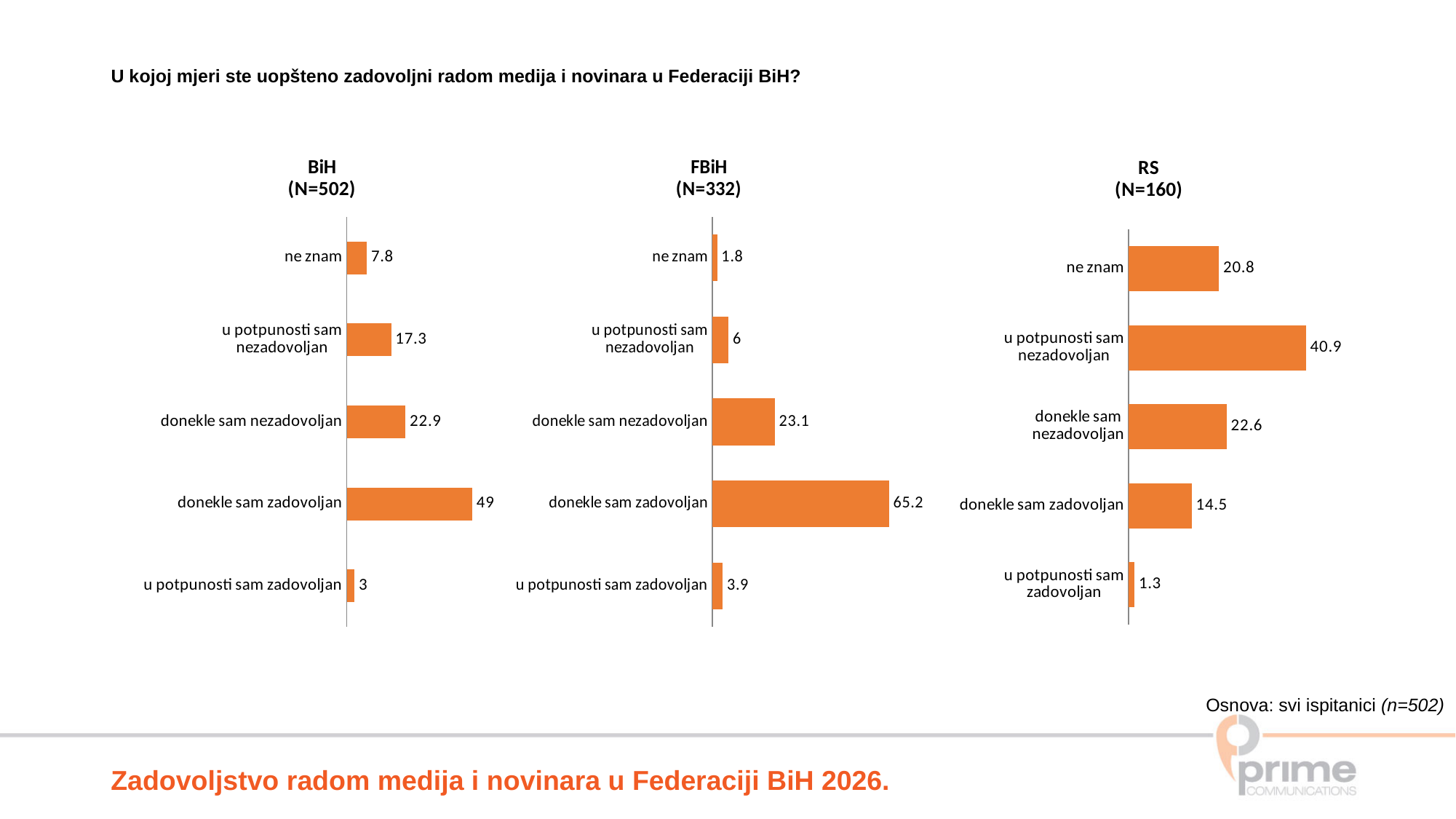
In the FBiH (N=332) chart, which category has the lowest value? ne znam What type of chart is the BiH (N=502) chart? bar chart In the FBiH (N=332) chart, what is the difference between 'donekle sam zadovoljan' and 'donekle sam nezadovoljan'? 42.1 How many charts are shown on the slide? 3 In the BiH (N=502) chart, what is the difference between 'donekle sam nezadovoljan' and 'u potpunosti sam nezadovoljan'? 5.6 In the RS (N=160) chart, which is larger: 'ne znam' or 'donekle sam zadovoljan'? ne znam In the BiH (N=502) chart, which category has the lowest value? u potpunosti sam zadovoljan How many categories does the FBiH (N=332) chart show? 5 In the BiH (N=502) chart, what is the value for 'donekle sam zadovoljan'? 49 In the FBiH (N=332) chart, what is the value for 'ne znam'? 1.8 In the RS (N=160) chart, what is the value for 'u potpunosti sam nezadovoljan'? 40.9 In the RS (N=160) chart, which category has the highest value? u potpunosti sam nezadovoljan